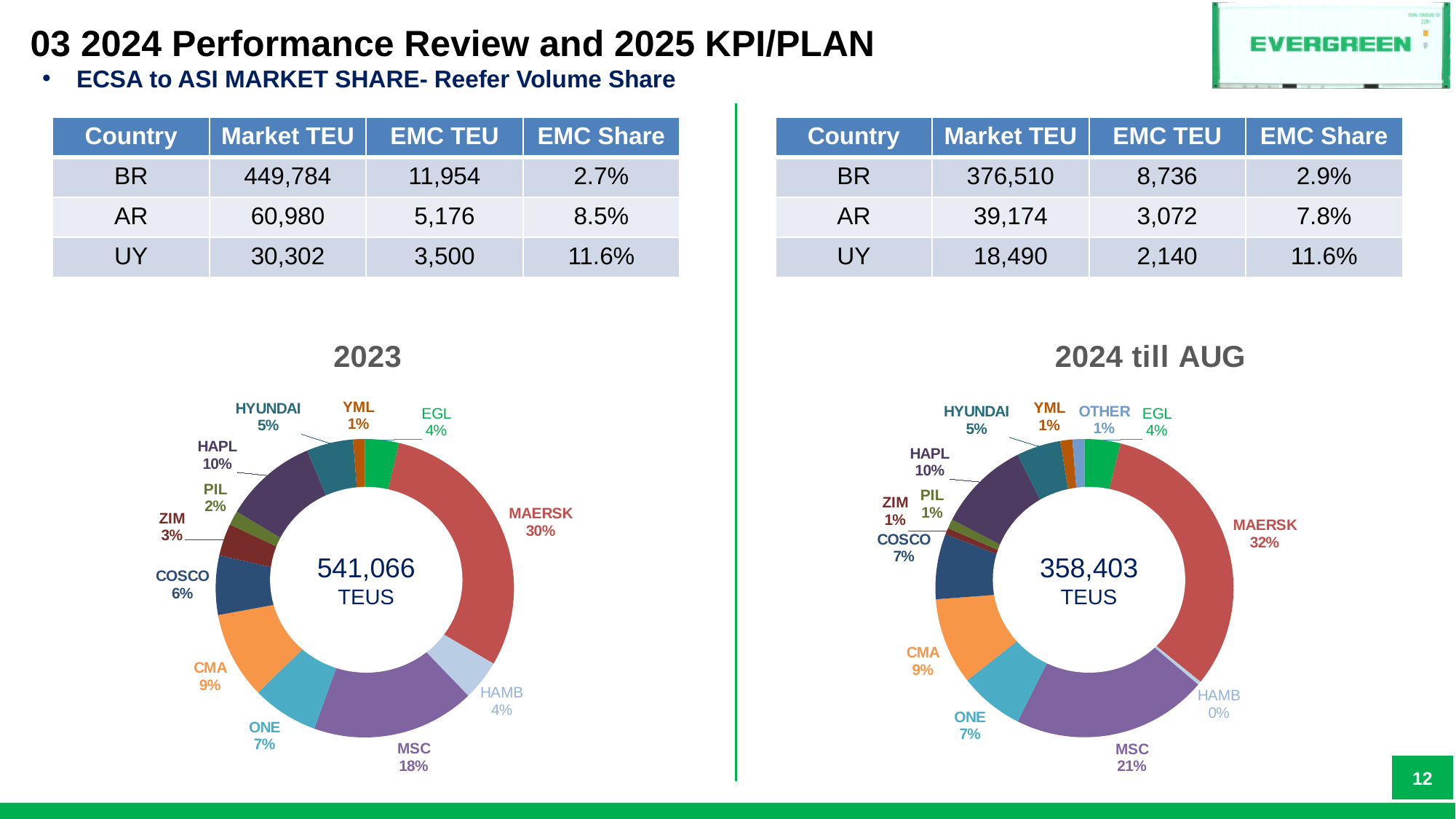
In the 2024 till AUG chart, which carrier has the largest share? MAERSK What total volume is shown in the centre of the 2024 till AUG chart? 358,403 TEUS In the 2024 till AUG chart, which has the larger share, CMA or COSCO? CMA What type of chart is the 2024 till AUG chart? Donut (pie) chart In the 2023 chart, what is the difference in share between MAERSK and MSC? 12% What total volume is shown in the centre of the 2023 chart? 541,066 TEUS In the 2024 till AUG chart, what share does MSC hold? 21% In the 2024 till AUG chart, which carrier has the smallest share? HAMB In the 2023 chart, what share does MAERSK hold? 30% How many carrier slices are shown in the 2023 chart? 12 In the 2023 chart, which carrier has the smallest share? YML In the 2023 chart, what share does EGL hold? 4%